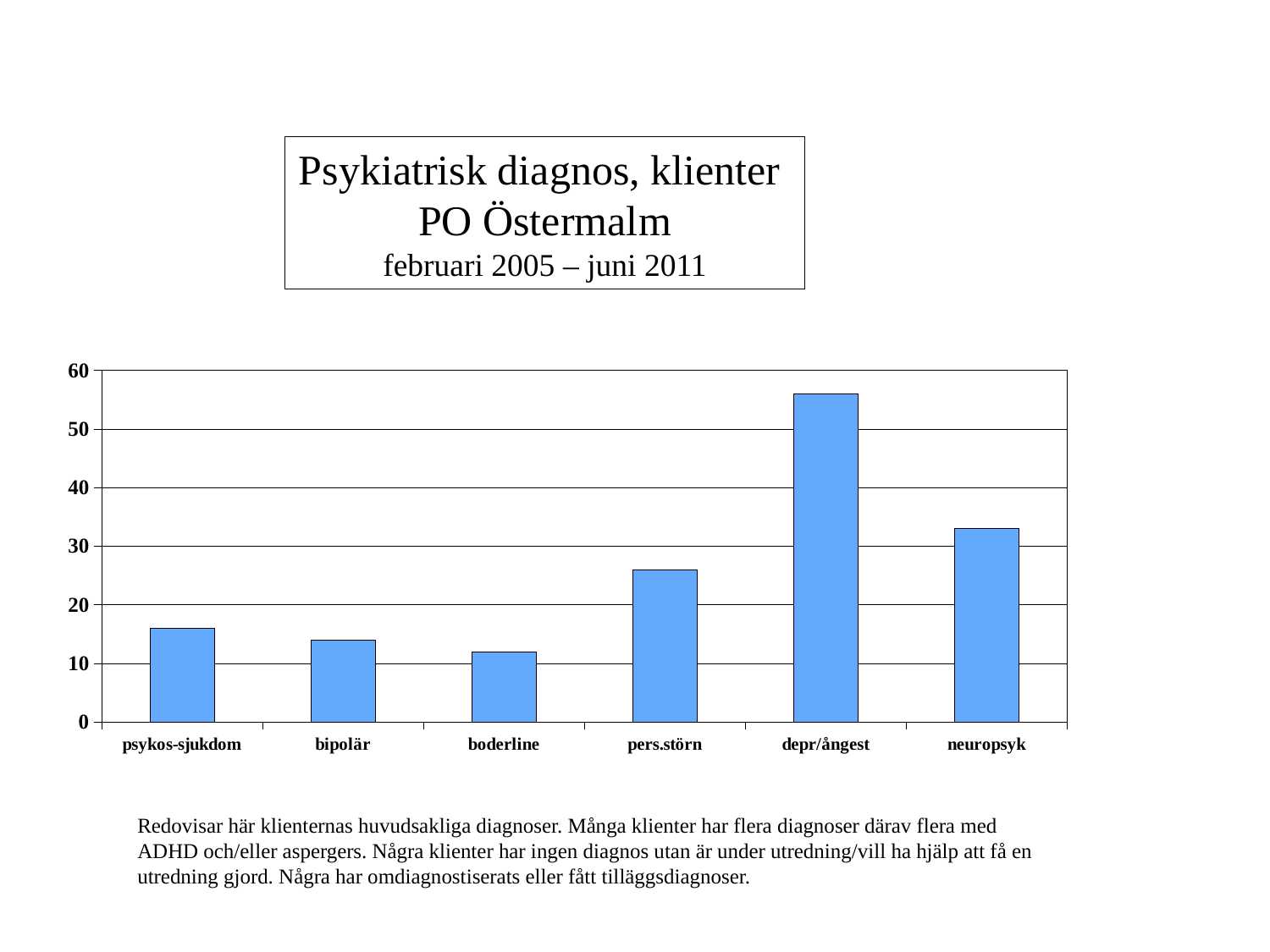
Which is larger, the value for neuropsyk or the value for pers.störn? neuropsyk Is the value for boderline greater or less than 10? greater How many categories are shown on the x axis of the chart? 6 Is the value for psykos-sjukdom greater or less than 20? less What kind of chart is shown on the slide? bar chart Which category has the highest value in the chart? depr/ångest Is the value for neuropsyk greater or less than 30? greater What is the title of the chart on the slide? Psykiatrisk diagnos, klienter PO Östermalm februari 2005 – juni 2011 What is the highest value shown on the y axis of the chart? 60 Which is larger, the value for psykos-sjukdom or the value for depr/ångest? depr/ångest